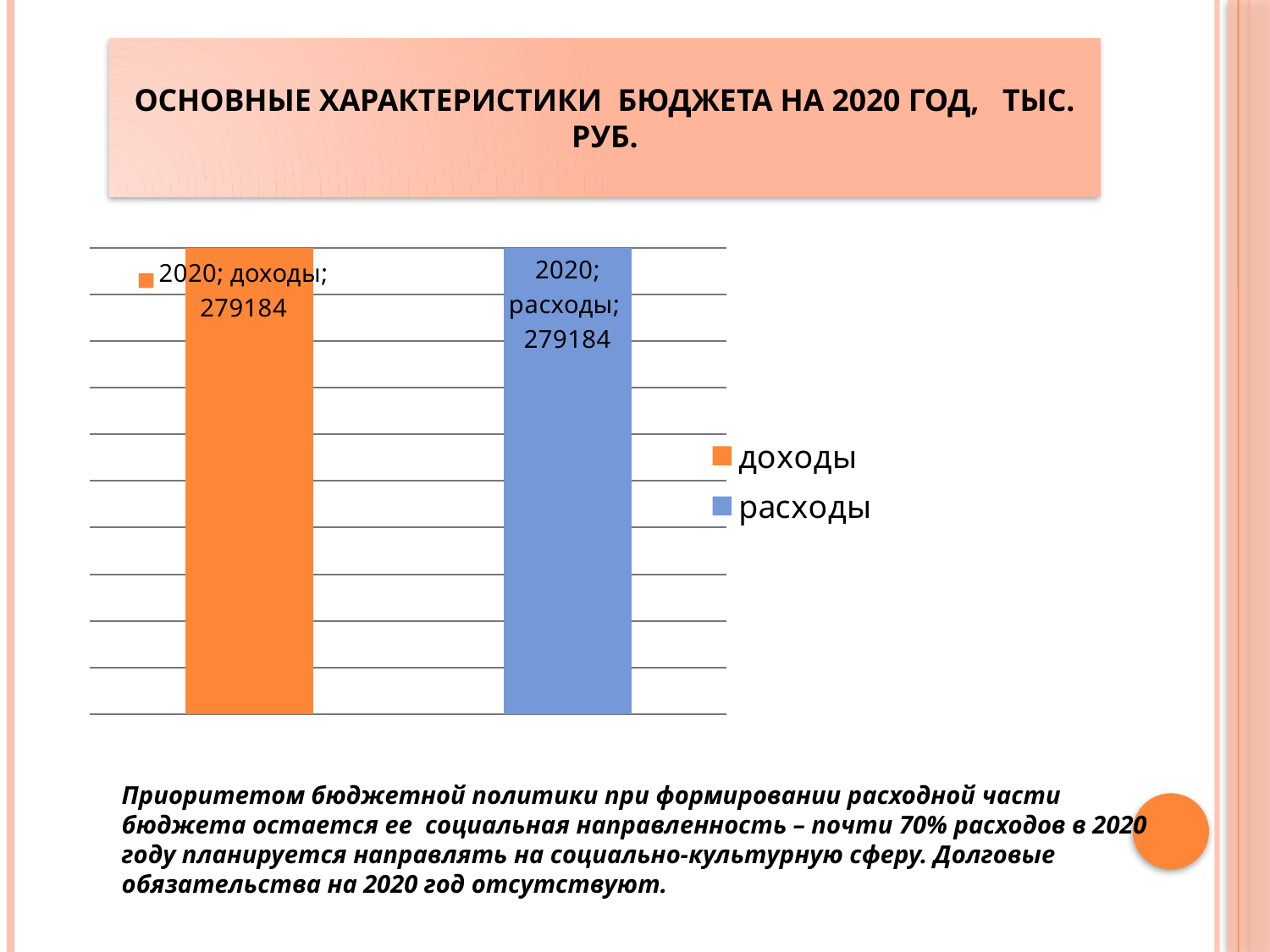
What is the difference between доходы and расходы for 2020? 0 Which series is shown in blue? расходы Which series is shown in orange? доходы What is the value of доходы for 2020? 279184 How many series does the legend list? 2 Which year do the bars on the chart refer to? 2020 What is the value of расходы for 2020? 279184 How many bars are plotted on the chart? 2 Are доходы and расходы for 2020 equal, or is one larger? They are equal What kind of chart is shown on the slide? Bar chart